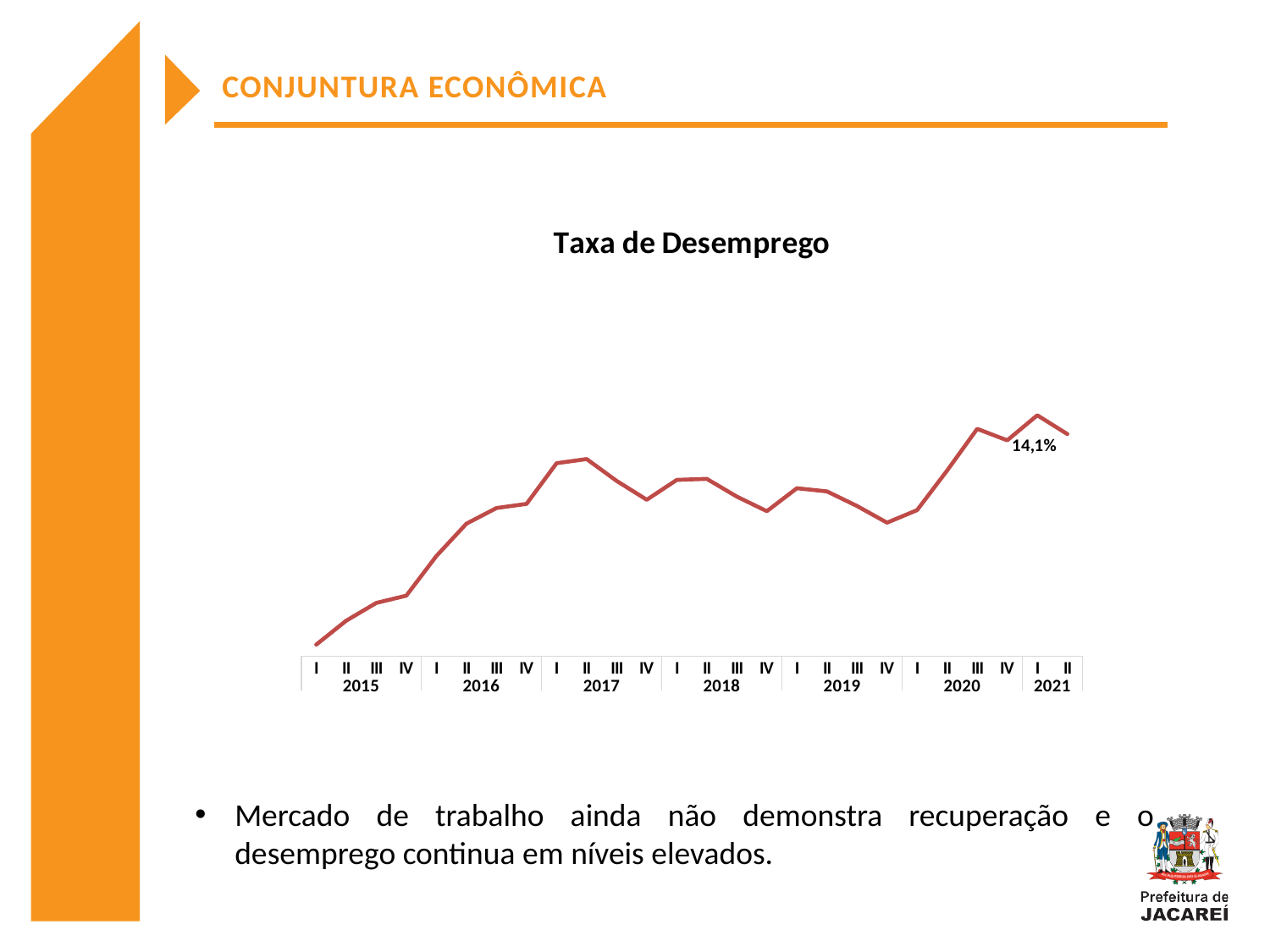
What colour is the line in the chart? red What is the title of the chart? Taxa de Desemprego Which quarter has the highest unemployment rate on the chart? I 2021 Which is higher, the unemployment rate in II 2017 or in IV 2019? II 2017 What value is printed as a data label at the end of the line? 14,1% How many years are labelled along the x axis? 7 Does the unemployment rate rise or fall from I 2019 to IV 2019? fall Does the unemployment rate rise or fall from I 2015 to IV 2016? rise Which is higher, the unemployment rate in I 2015 or in II 2021? II 2021 What kind of chart is shown on the slide? line chart Which quarter has the lowest unemployment rate on the chart? I 2015 How many quarterly data points are plotted on the line? 26